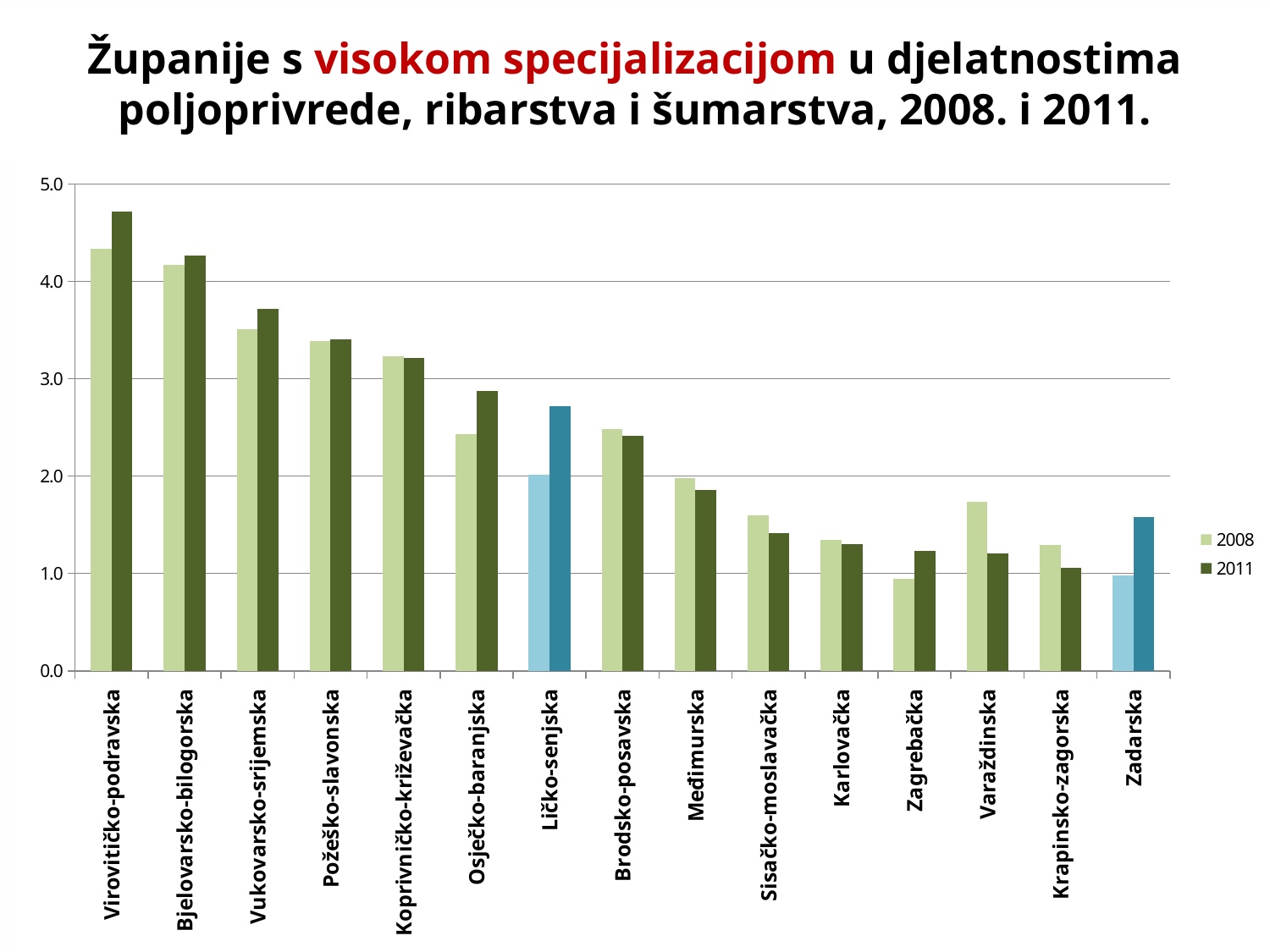
Which county has the highest value for 2011? Virovitičko-podravska For Varaždinska, which year has the larger value, 2008 or 2011? 2008 Is the 2008 value for Vukovarsko-srijemska greater or less than 3.0? greater For Ličko-senjska, which year has the larger value, 2008 or 2011? 2011 Which county has the highest value for 2008? Virovitičko-podravska How many series does the legend list? 2 How many counties (categories) are shown on the x axis? 15 Is the 2011 value for Virovitičko-podravska greater or less than 4.0? greater Is the 2011 value for Osječko-baranjska greater or less than 3.0? less What kind of chart is shown on the slide? bar chart Do the 2011 values generally rise or fall from left to right along the x axis? fall